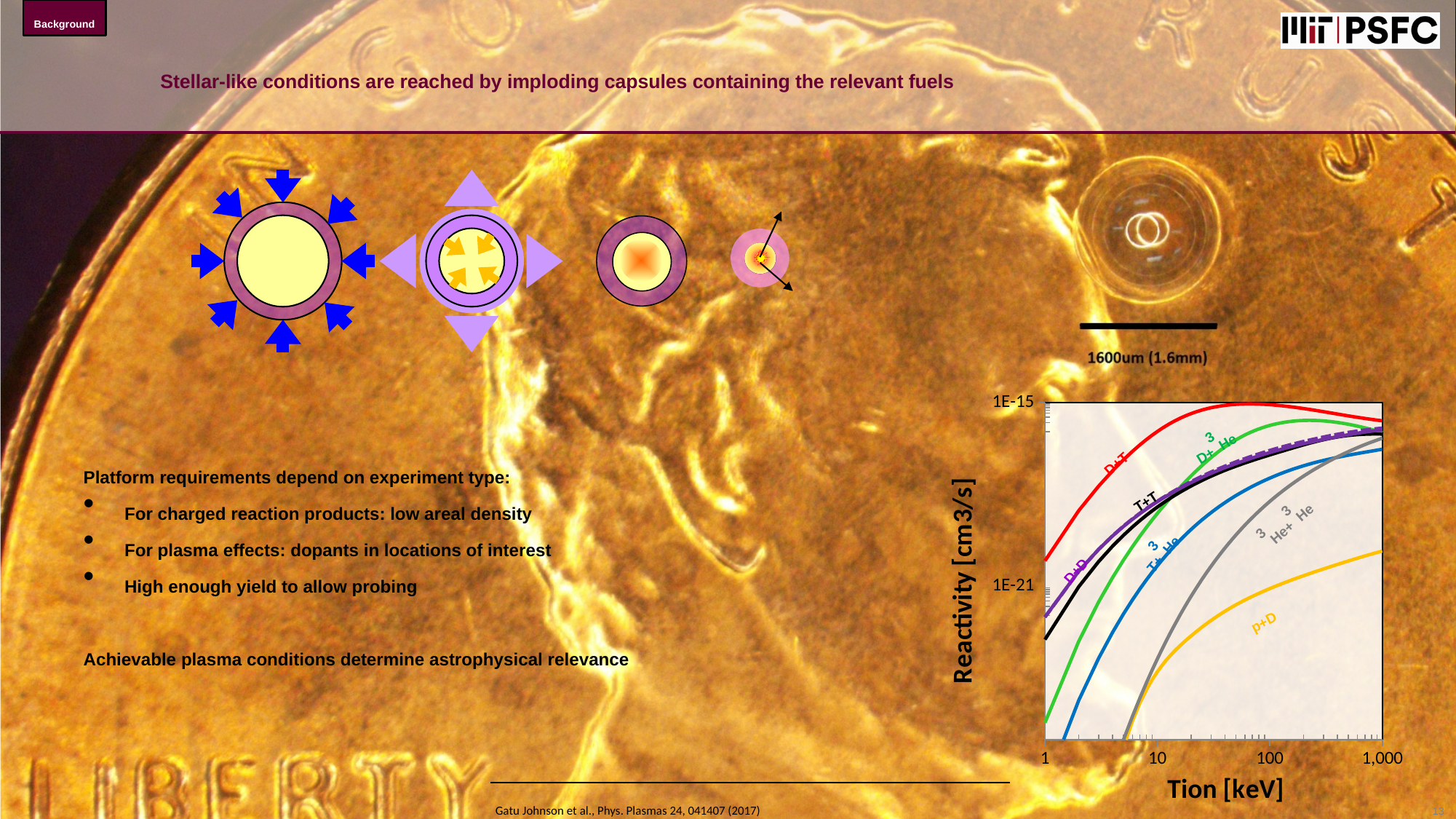
What is the highest Tion value shown on the x axis? 1,000 What is the label of the x axis of the chart? Tion [keV] Which reaction has the highest reactivity curve on the chart? D+T Is the p+D reactivity at Tion = 10 keV greater or less than 1E-21? less At Tion = 10 keV, which has the larger reactivity, D+T or p+D? D+T At Tion = 10 keV, which has the larger reactivity, T+T or 3He+3He? T+T What kind of chart is shown on the slide? line chart Which reaction has the lowest reactivity curve on the chart? p+D Does the p+D reactivity curve rise or fall as Tion increases? rise Is the D+T reactivity at Tion = 100 keV greater or less than 1E-21? greater What is the label of the y axis of the chart? Reactivity [cm3/s]